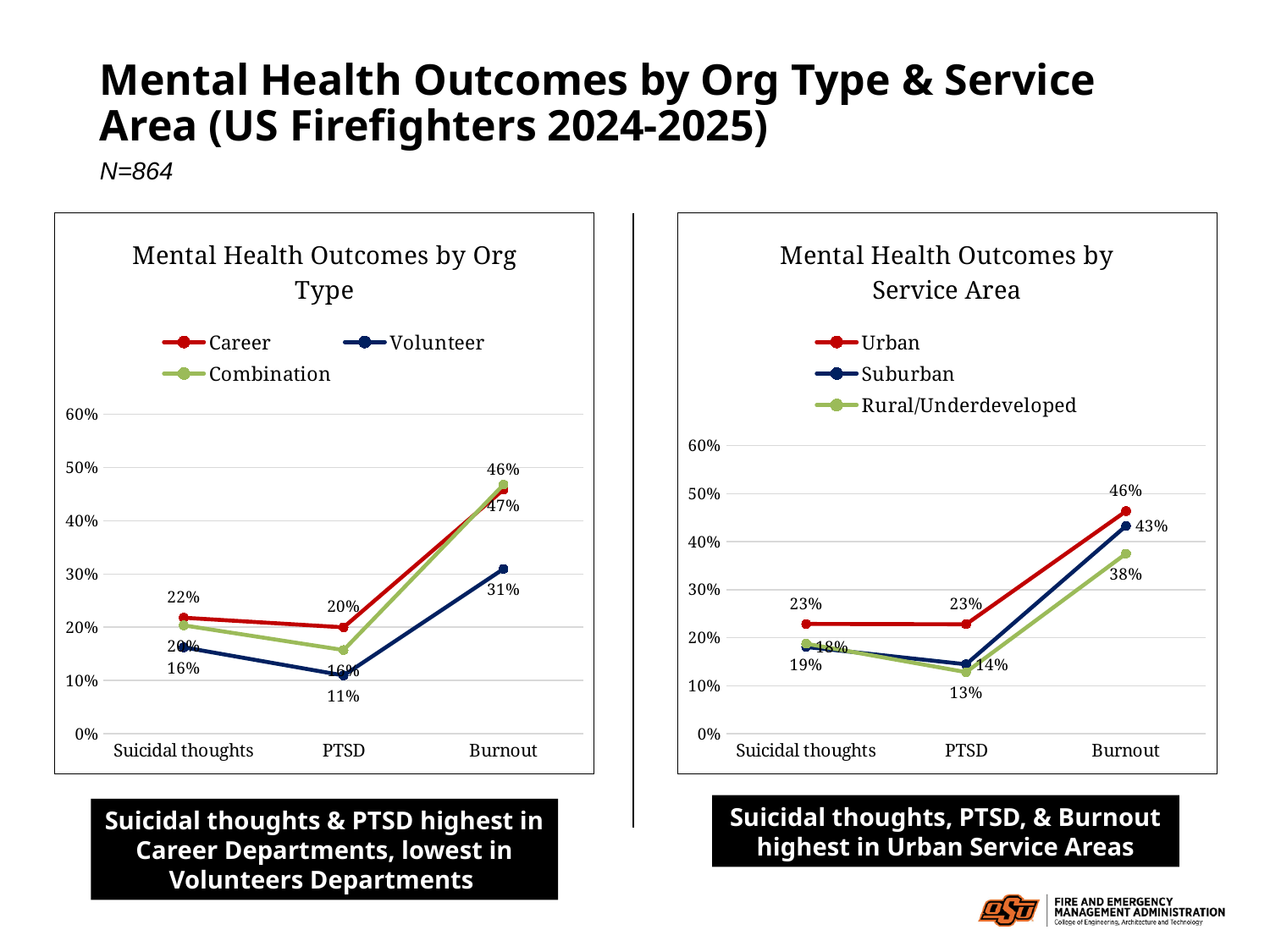
In the 'Mental Health Outcomes by Org Type' chart, what is the value for Volunteer at PTSD? 11% In the 'Mental Health Outcomes by Service Area' chart, what is the value for Rural/Underdeveloped at Burnout? 38% In the 'Mental Health Outcomes by Org Type' chart, what is the difference between Career and Volunteer at Suicidal thoughts? 6 percentage points In the 'Mental Health Outcomes by Service Area' chart, how many categories are shown on the x axis? 3 What kind of chart is the 'Mental Health Outcomes by Org Type' chart on the left? Line chart In the 'Mental Health Outcomes by Org Type' chart, what is the value for Volunteer at Burnout? 31% In the 'Mental Health Outcomes by Org Type' chart, what is the value for Career at Suicidal thoughts? 22% In the 'Mental Health Outcomes by Org Type' chart, how many series does the legend list? 3 In the 'Mental Health Outcomes by Org Type' chart, which series has the lowest value at PTSD? Volunteer In the 'Mental Health Outcomes by Service Area' chart, what is the value for Urban at Burnout? 46% In the 'Mental Health Outcomes by Service Area' chart, what is the difference between Urban and Rural/Underdeveloped at Burnout? 8 percentage points In the 'Mental Health Outcomes by Service Area' chart, which is larger at PTSD, Urban or Suburban? Urban